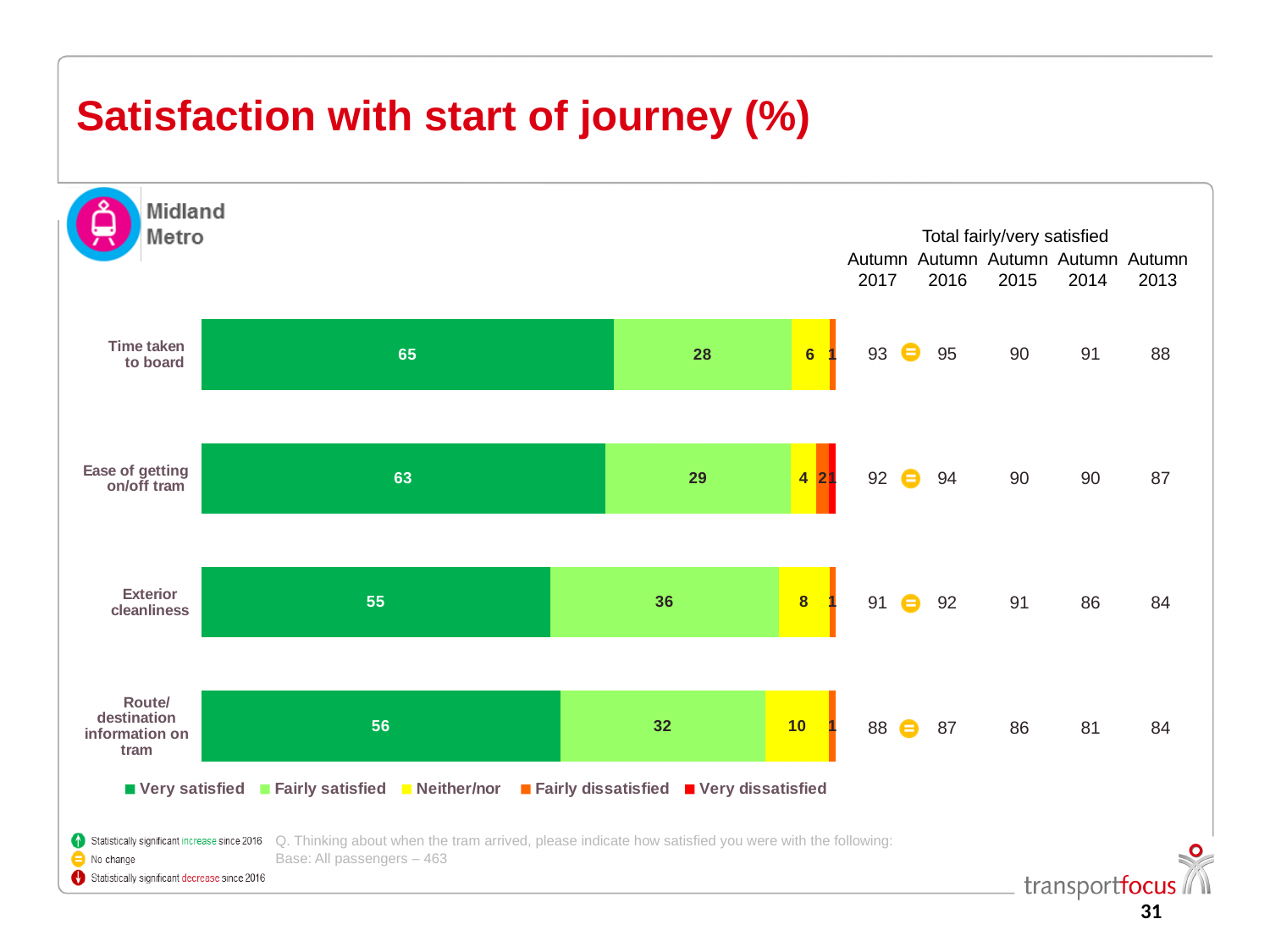
What is the difference between the 'Very satisfied' values for 'Time taken to board' and 'Ease of getting on/off tram'? 2 Which category has the highest 'Very satisfied' value? Time taken to board How many categories are plotted in the chart? 4 What is the total fairly/very satisfied figure for 'Route/destination information on tram' in Autumn 2014? 81 How many series does the legend list? 5 What is the 'Neither/nor' value for 'Route/destination information on tram'? 10 What is the 'Very satisfied' value for 'Time taken to board'? 65 What is the 'Fairly satisfied' value for 'Exterior cleanliness'? 36 What is the total fairly/very satisfied figure for 'Ease of getting on/off tram' in Autumn 2017? 92 Which is larger: the 'Fairly satisfied' value for 'Exterior cleanliness' or for 'Route/destination information on tram'? Exterior cleanliness Which category has the lowest 'Very satisfied' value? Exterior cleanliness What kind of chart is shown on the slide? Stacked bar chart